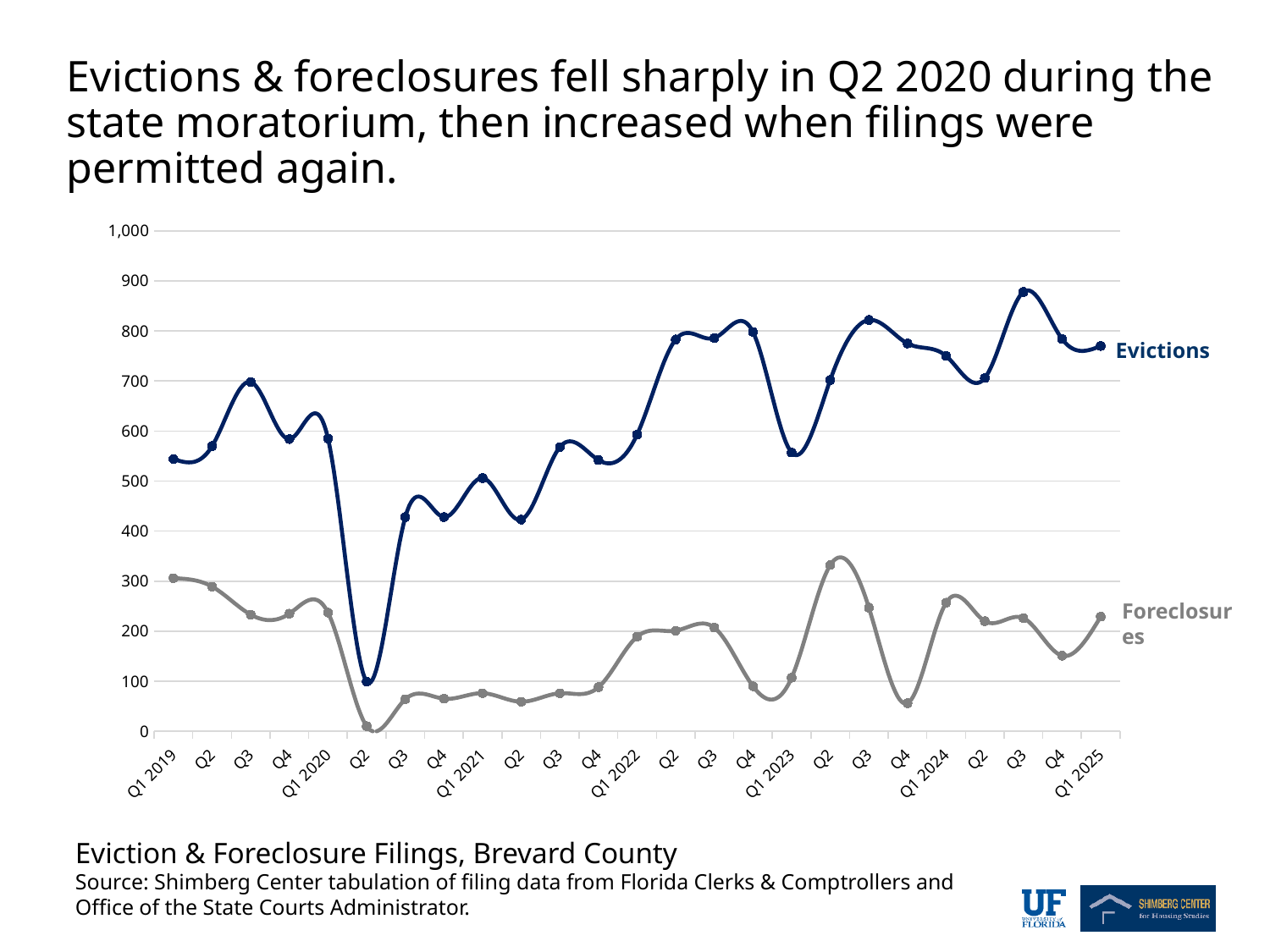
What kind of chart is shown on the slide? line chart What is the chart's title as given below the plot? Eviction & Foreclosure Filings, Brevard County In which quarter do Foreclosures reach their lowest value? Q2 2020 Is the value for Evictions in Q3 2024 greater or less than 800? greater In which quarter do Foreclosures reach their highest value? Q2 2023 Is the value for Evictions in Q2 2020 greater or less than 200? less In which quarter do Evictions reach their lowest value? Q2 2020 Which series has the larger value in Q1 2019, Evictions or Foreclosures? Evictions How many series does the chart show? 2 How many quarterly data points does each line have, from Q1 2019 to Q1 2025? 25 Is the value for Foreclosures in Q4 2023 greater or less than 100? less In which quarter do Evictions reach their highest value? Q3 2024